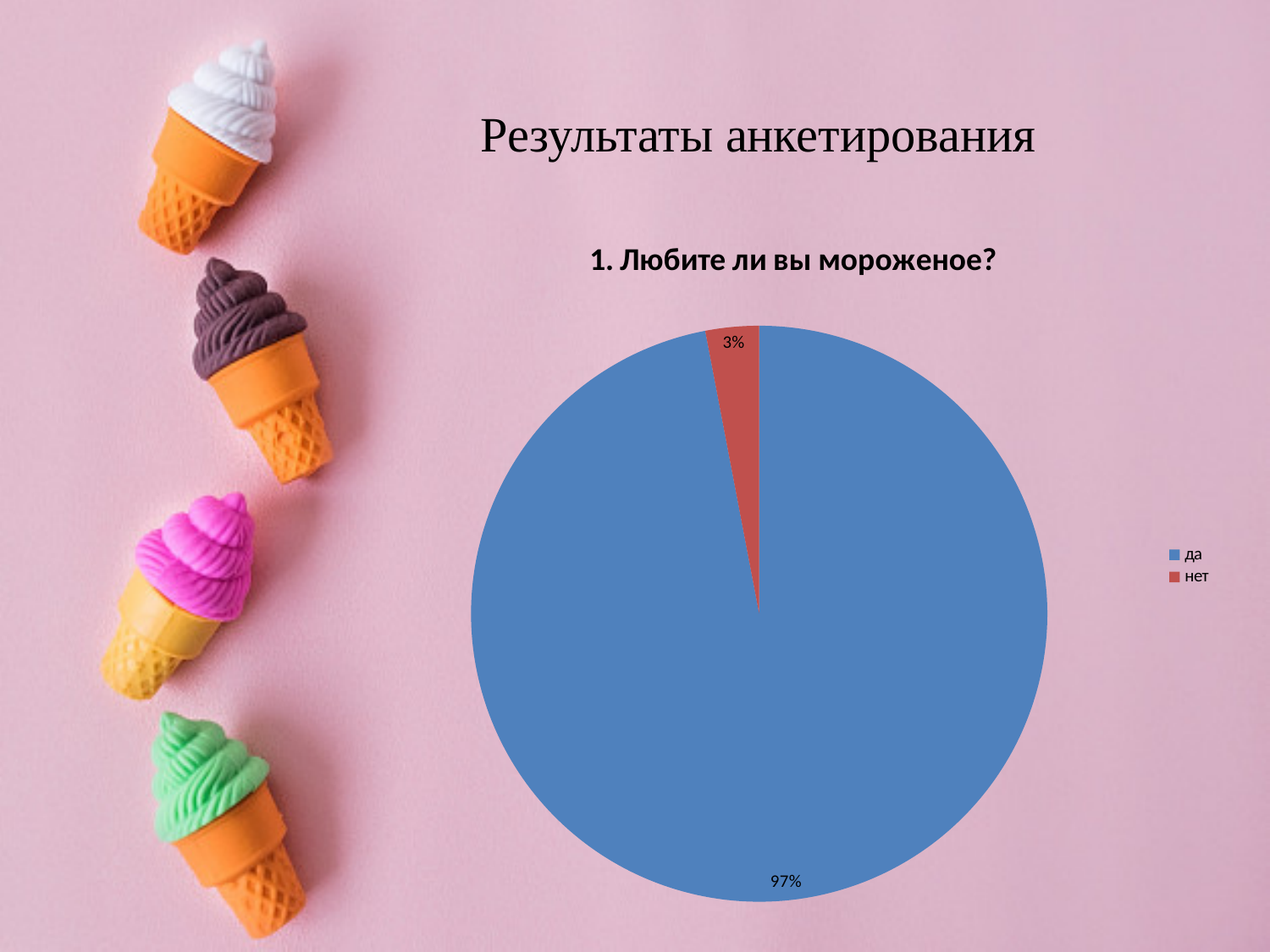
What share of the pie does the "нет" slice represent? 3% What is the title of the chart? 1. Любите ли вы мороженое? What share of the pie does the "да" slice represent? 97% Which category has the smallest slice of the pie? нет Which is larger, the "да" slice or the "нет" slice? да What kind of chart is shown on the slide? pie chart Which category has the largest slice of the pie? да What colour is the "нет" slice? red What is the difference in percentage points between the "да" and "нет" slices? 94 How many entries does the legend list? 2 How many categories does the pie chart have? 2